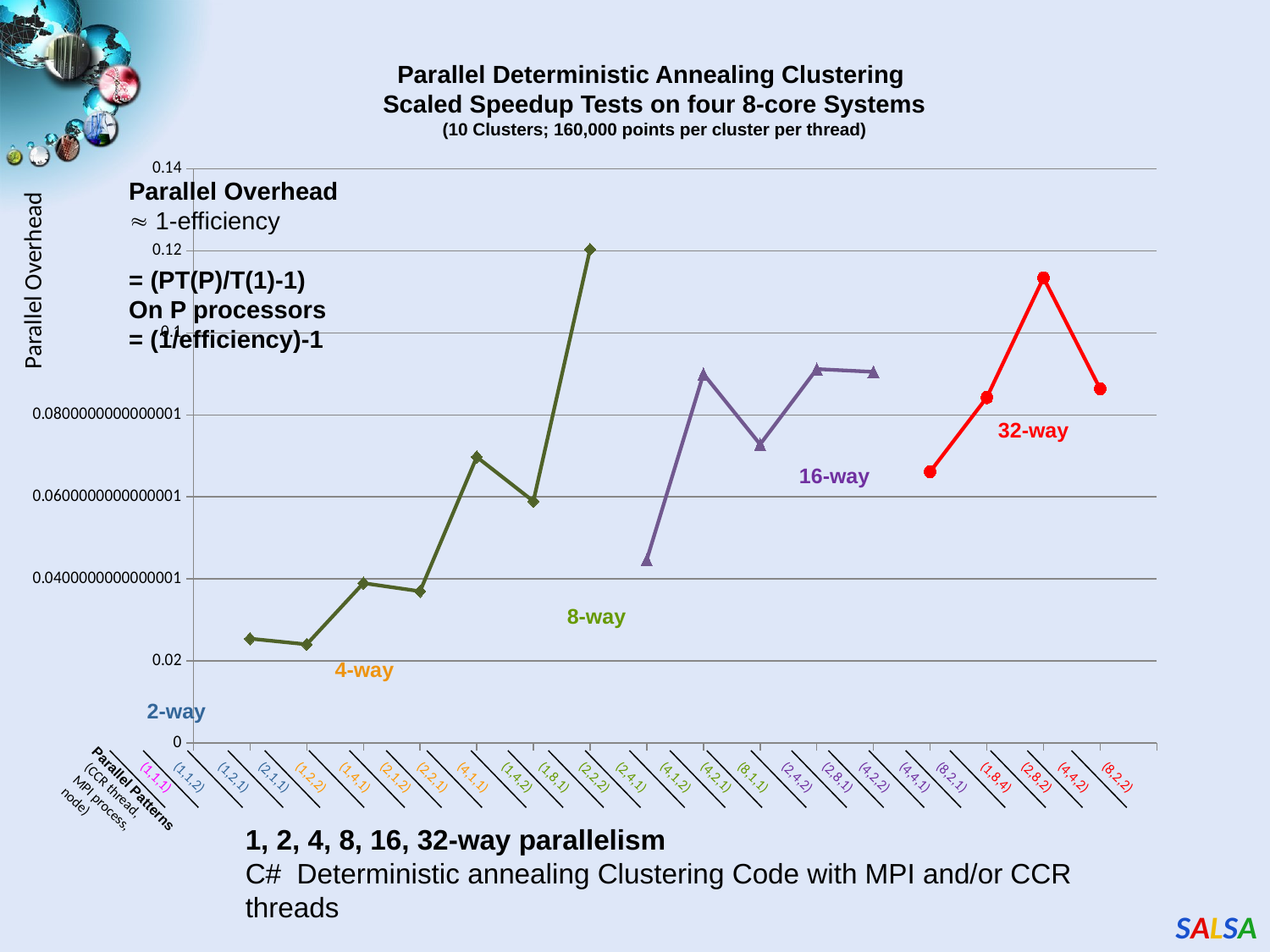
What is the title of the chart? Parallel Deterministic Annealing Clustering Scaled Speedup Tests on four 8-core Systems Is the parallel overhead for (2,8,2) greater or less than 0.12? less How many parallel pattern categories are listed along the x axis? 25 What is the label on the vertical axis of the chart? Parallel Overhead What kind of chart is shown on the slide? line chart